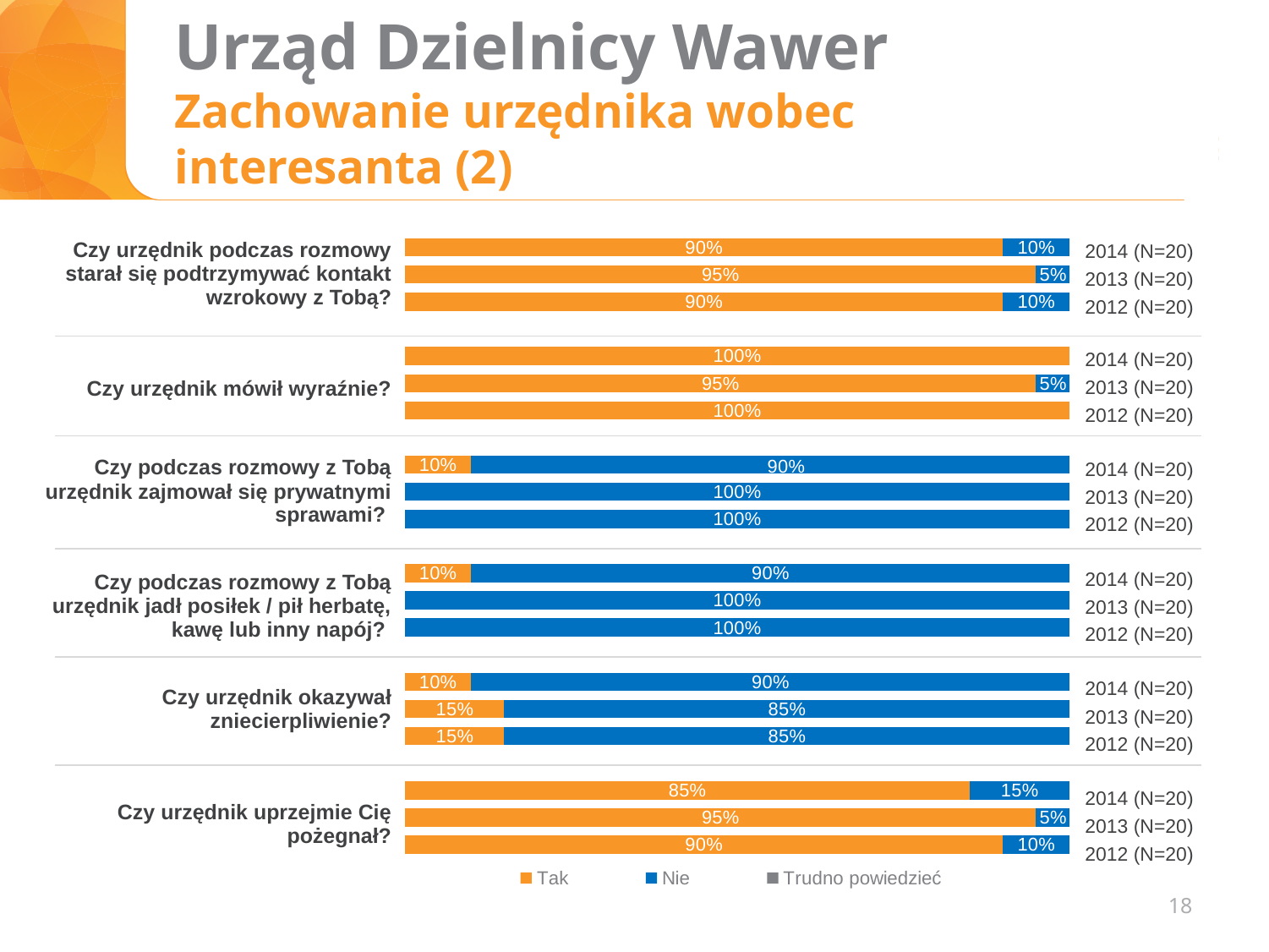
How many survey questions are shown on the chart? 6 Which is larger: the "Nie" share for "Czy urzędnik okazywał zniecierpliwienie?" in 2014 (N=20) or in 2012 (N=20)? 2014 (N=20) What share answered "Nie" to "Czy urzędnik mówił wyraźnie?" in 2013 (N=20)? 5% What is the difference between the "Tak" share for "Czy urzędnik uprzejmie Cię pożegnał?" in 2013 (N=20) and in 2014 (N=20)? 10% How many series does the legend list? 3 For "Czy urzędnik uprzejmie Cię pożegnał?", in which year was the "Tak" share highest? 2013 (N=20) Which colour represents "Nie" in the legend? Blue What share answered "Tak" to "Czy urzędnik podczas rozmowy starał się podtrzymywać kontakt wzrokowy z Tobą?" in 2014 (N=20)? 90% What kind of chart is shown on the slide? Stacked bar chart What share answered "Tak" to "Czy urzędnik okazywał zniecierpliwienie?" in 2013 (N=20)? 15% For "Czy urzędnik mówił wyraźnie?", in which year was the "Tak" share lowest? 2013 (N=20) What share answered "Nie" to "Czy urzędnik uprzejmie Cię pożegnał?" in 2014 (N=20)? 15%